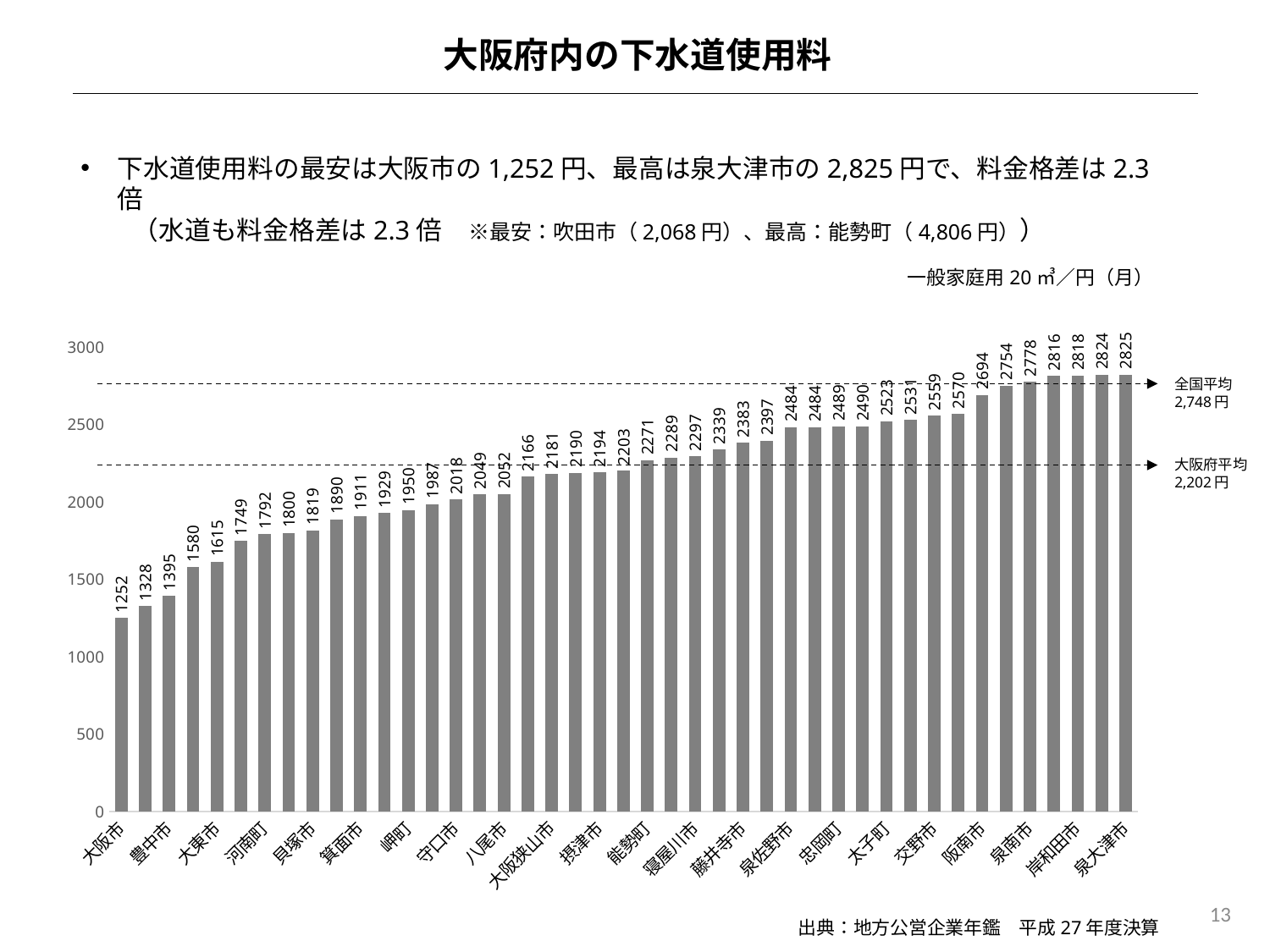
Which municipality has the lowest bar in the chart? 大阪市 Is the value for 豊中市 greater or less than 1500? less How many bars (municipalities) are plotted in the chart? 43 Which has a larger value, 岸和田市 or 豊中市? 岸和田市 What type of chart is shown on the slide? bar chart What is the sewer fee value shown for 大阪市? 1252 What is the difference between the values for 泉大津市 and 大阪市? 1573 Do the bar values rise or fall from left to right along the x axis? rise Which municipality has the highest bar in the chart? 泉大津市 What value is given for the 全国平均 reference line in the chart? 2,748円 What is the sewer fee value shown for 泉大津市? 2825 Is the value for 岸和田市 greater or less than 2500? greater